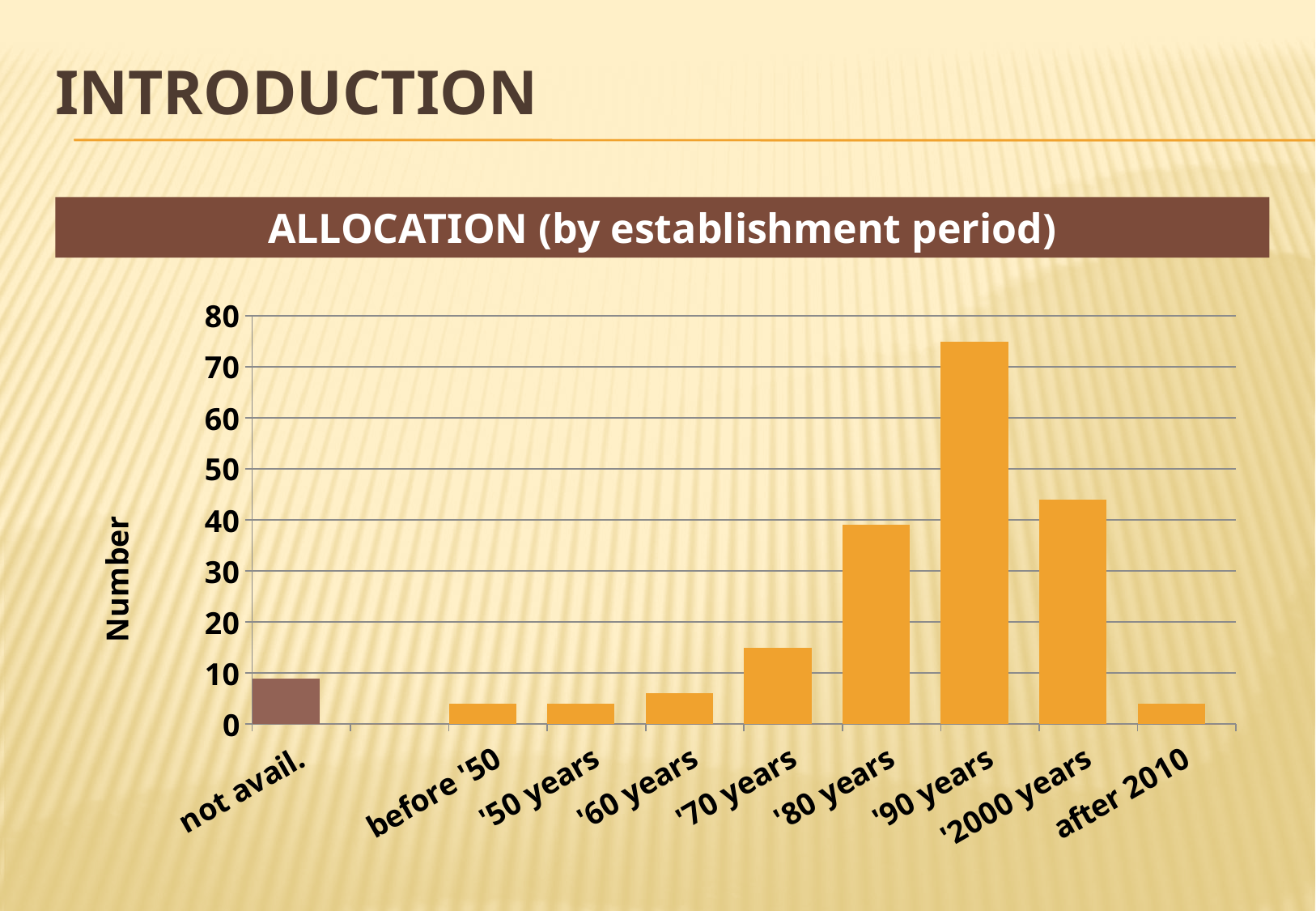
Is the value for '2000 years greater or less than 40? greater What is the title of the chart? ALLOCATION (by establishment period) Which is larger, the value for '70 years or the value for '60 years? '70 years What is the label on the vertical axis? Number Which is larger, the value for '80 years or the value for '2000 years? '2000 years How many categories are shown on the x axis? 9 What kind of chart is shown on the slide? bar chart Is the value for '90 years greater or less than 70? greater Which establishment period has the highest number? '90 years Is the value for '70 years greater or less than 20? less